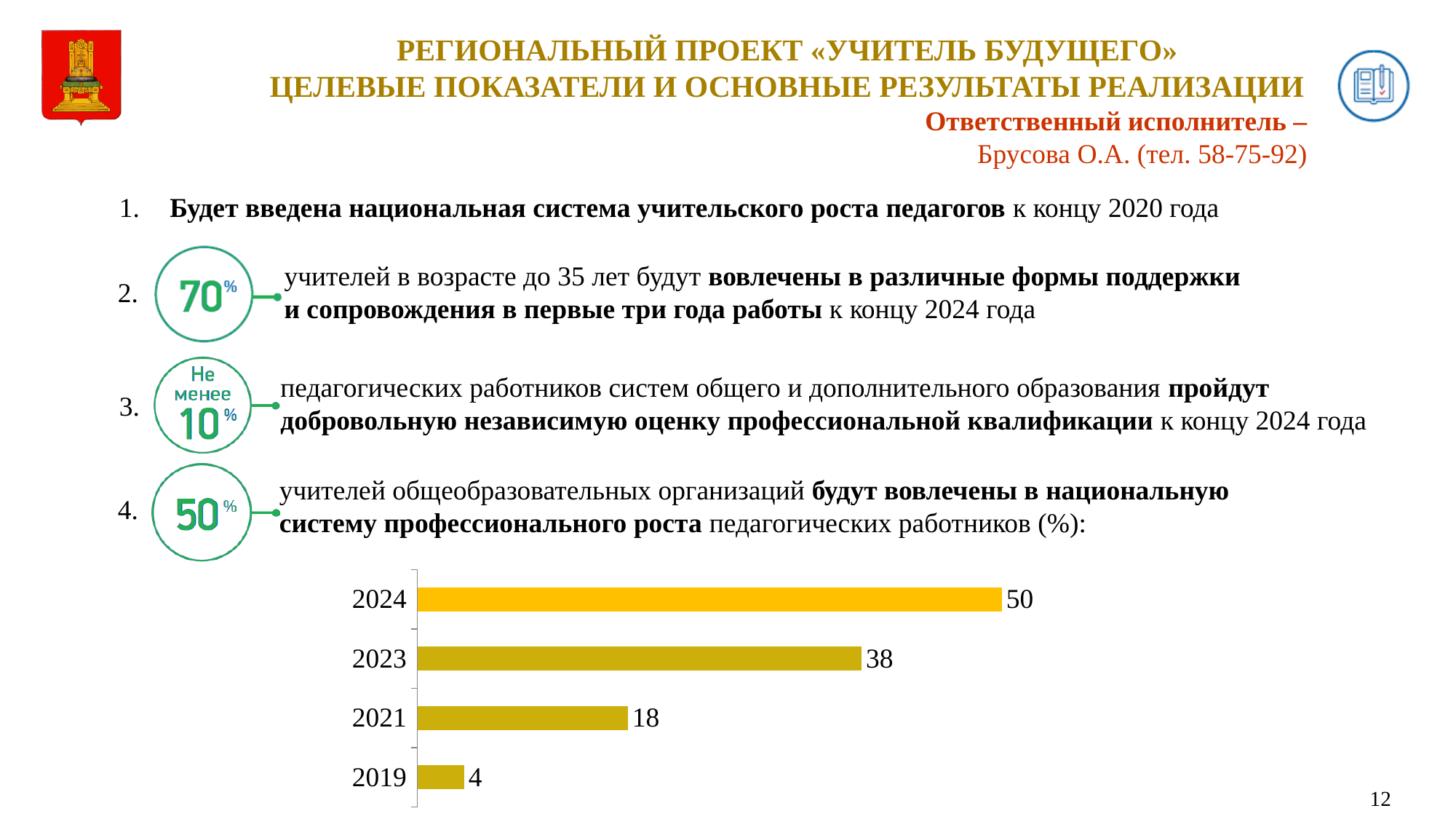
Do the values in the bar chart increase or decrease from 2019 to 2024? increase Which year has the highest value in the bar chart? 2024 Which year has the lowest value in the bar chart? 2019 What is the value for 2024 in the bar chart? 50 What kind of chart is shown on the slide? bar chart What is the value for 2023 in the bar chart? 38 What is the value for 2019 in the bar chart? 4 What is the difference between the values for 2021 and 2019? 14 Which is larger, the value for 2023 or the value for 2021? 2023 How many years are shown in the bar chart? 4 What is the difference between the values for 2024 and 2023? 12 What is the value for 2021 in the bar chart? 18